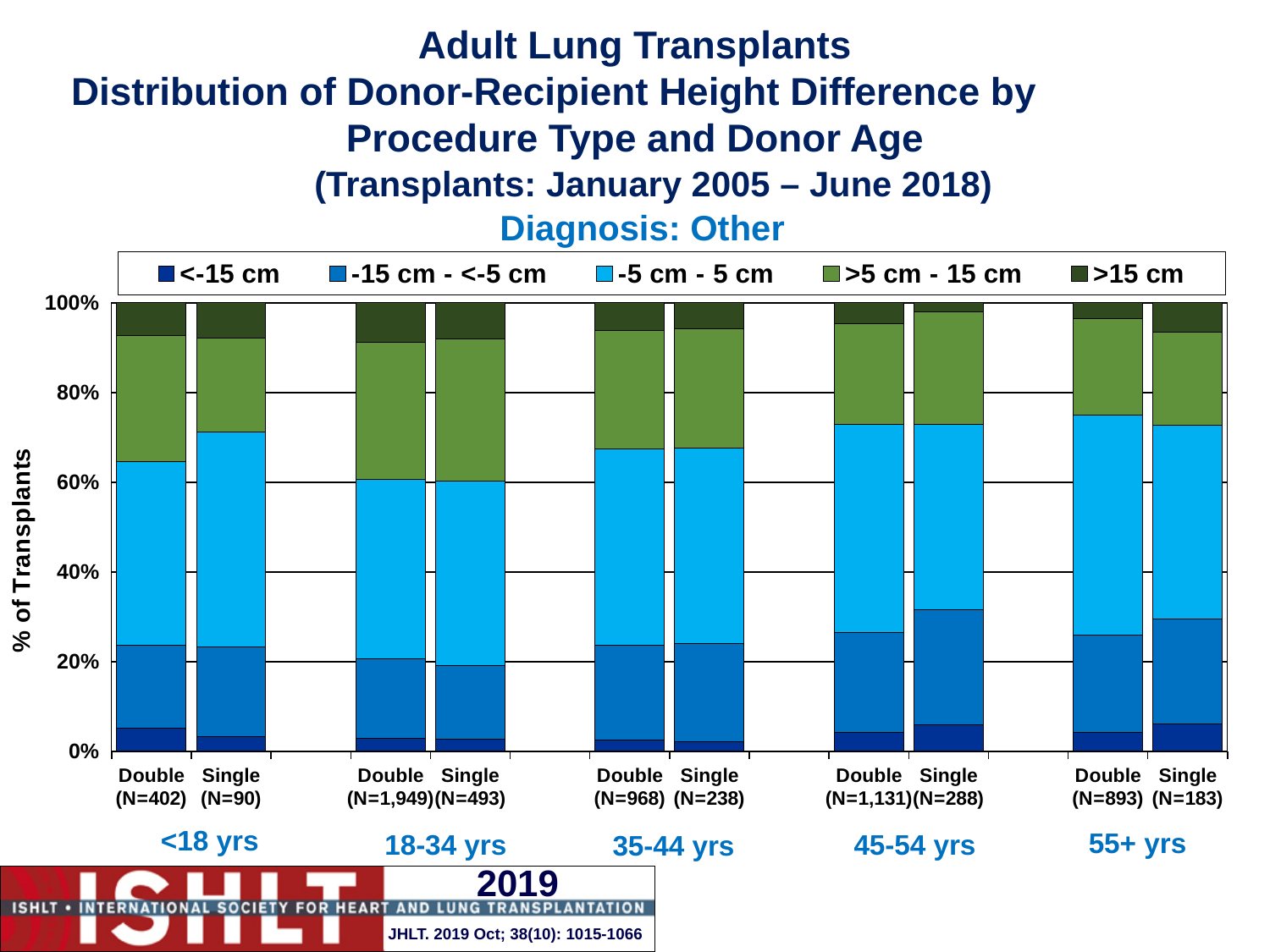
Is the top of the '-5 cm - 5 cm' segment for Double (N=893) greater or less than 60%? greater Is the top of the '-5 cm - 5 cm' segment for Single (N=90) greater or less than 60%? greater Which diagnosis is named in the chart's subtitle? Other Which bar has a larger '>5 cm - 15 cm' segment: Double (N=402) or Single (N=90)? Double (N=402) What is the N value shown for the Double bar in the 18-34 yrs group? N=1,949 What kind of chart is shown on the slide? Stacked bar chart How many series does the legend list? 5 How many bars are plotted in the chart? 10 Which bar has a larger '-15 cm - <-5 cm' segment: Single (N=288) or Single (N=493)? Single (N=288) How many donor age groups are shown along the x axis? 5 Is the '<-15 cm' segment for Double (N=402) greater or less than 20%? less